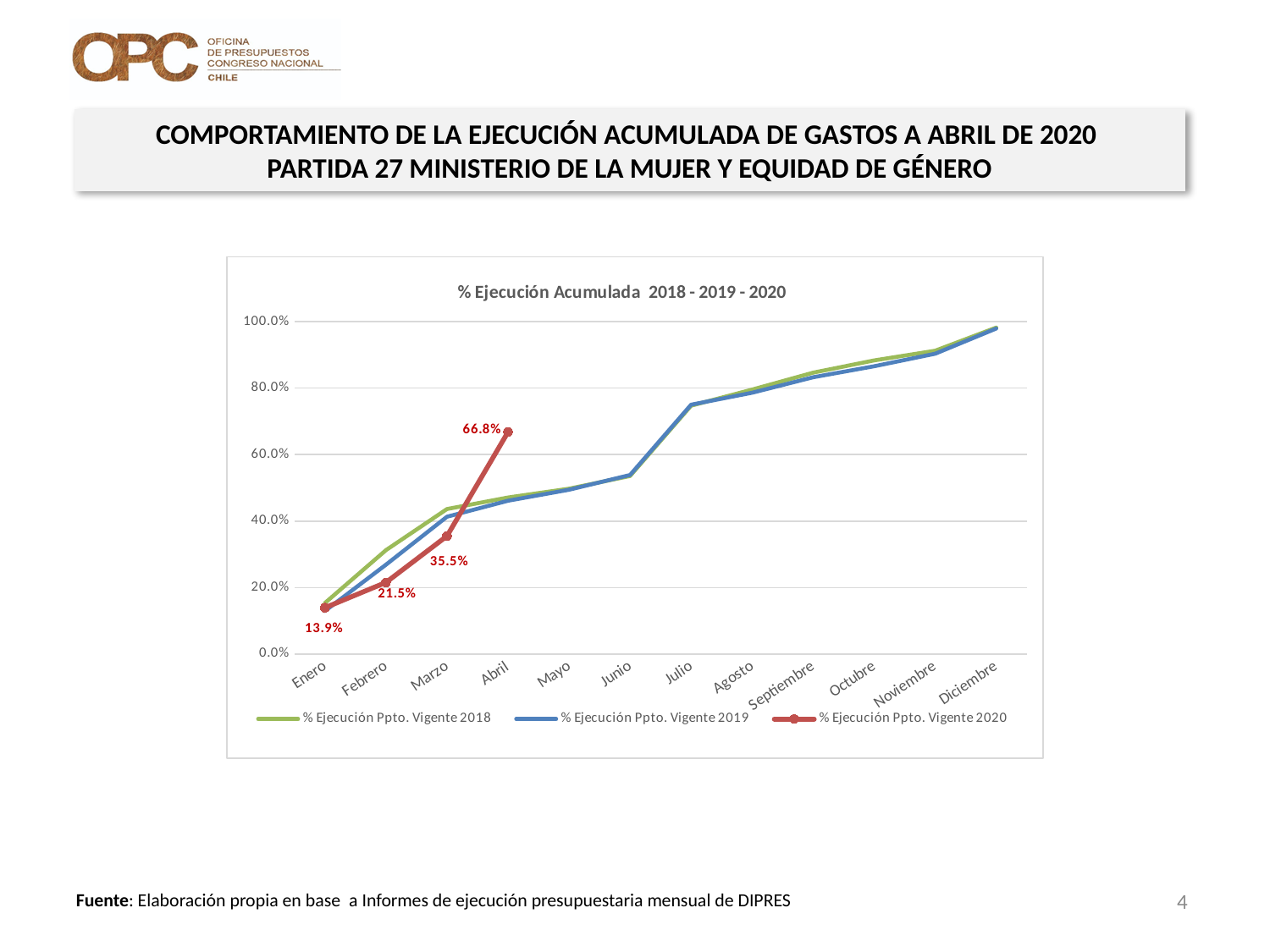
What is the value for Enero in the % Ejecución Ppto. Vigente 2020 series? 13.9% What is the title of the chart? % Ejecución Acumulada 2018 - 2019 - 2020 What is the difference between the Abril and Marzo values in the % Ejecución Ppto. Vigente 2020 series? 31.3 percentage points What kind of chart is shown on the slide? Line chart How many series does the chart legend list? 3 How many months are shown on the x axis of the chart? 12 What is the value for Abril in the % Ejecución Ppto. Vigente 2020 series? 66.8% Which month has the highest value in the % Ejecución Ppto. Vigente 2020 series? Abril What is the value for Marzo in the % Ejecución Ppto. Vigente 2020 series? 35.5% Is the value for Julio in the % Ejecución Ppto. Vigente 2019 series greater or less than 60.0%? greater What is the value for Febrero in the % Ejecución Ppto. Vigente 2020 series? 21.5% Which month has the lowest value in the % Ejecución Ppto. Vigente 2020 series? Enero